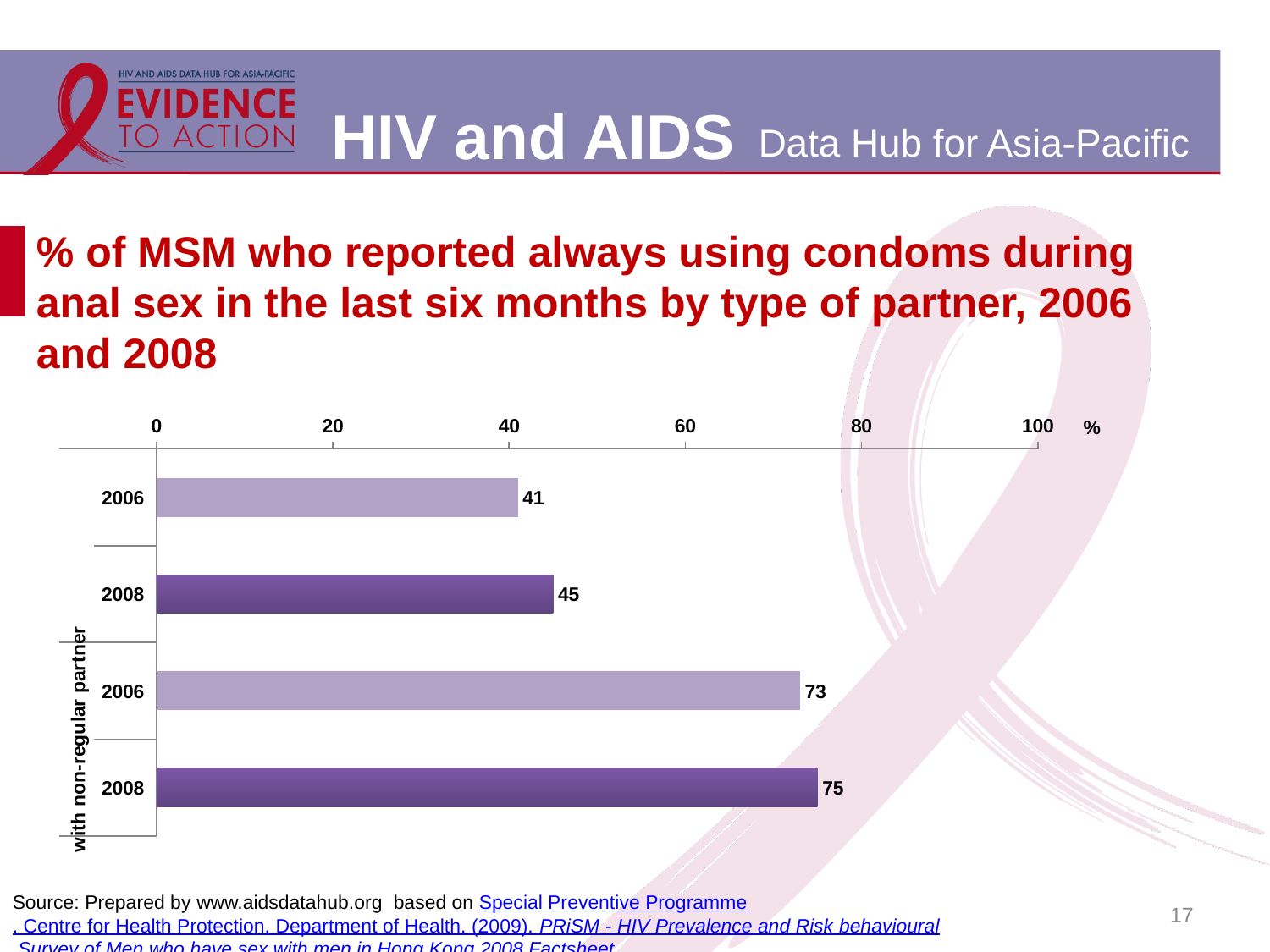
What is the value of the topmost bar (2006) in the chart? 41 How many bars are plotted in the chart? 4 What is the value of the 2008 bar in the 'with non-regular partner' group? 75 What is the value of the second bar from the top (2008) in the chart? 45 What kind of chart is shown on the slide? bar chart Which bar has the highest value in the chart? 2008 with non-regular partner (75) Is the 2006 value for 'with non-regular partner' greater or less than 60? greater What unit is shown at the end of the horizontal axis? % What is the difference between the 2008 and 2006 values in the 'with non-regular partner' group? 2 Which bar has the lowest value in the chart? the topmost 2006 bar (41) What is the value of the 2006 bar in the 'with non-regular partner' group? 73 What is the difference between the two topmost bars (2008 minus 2006)? 4